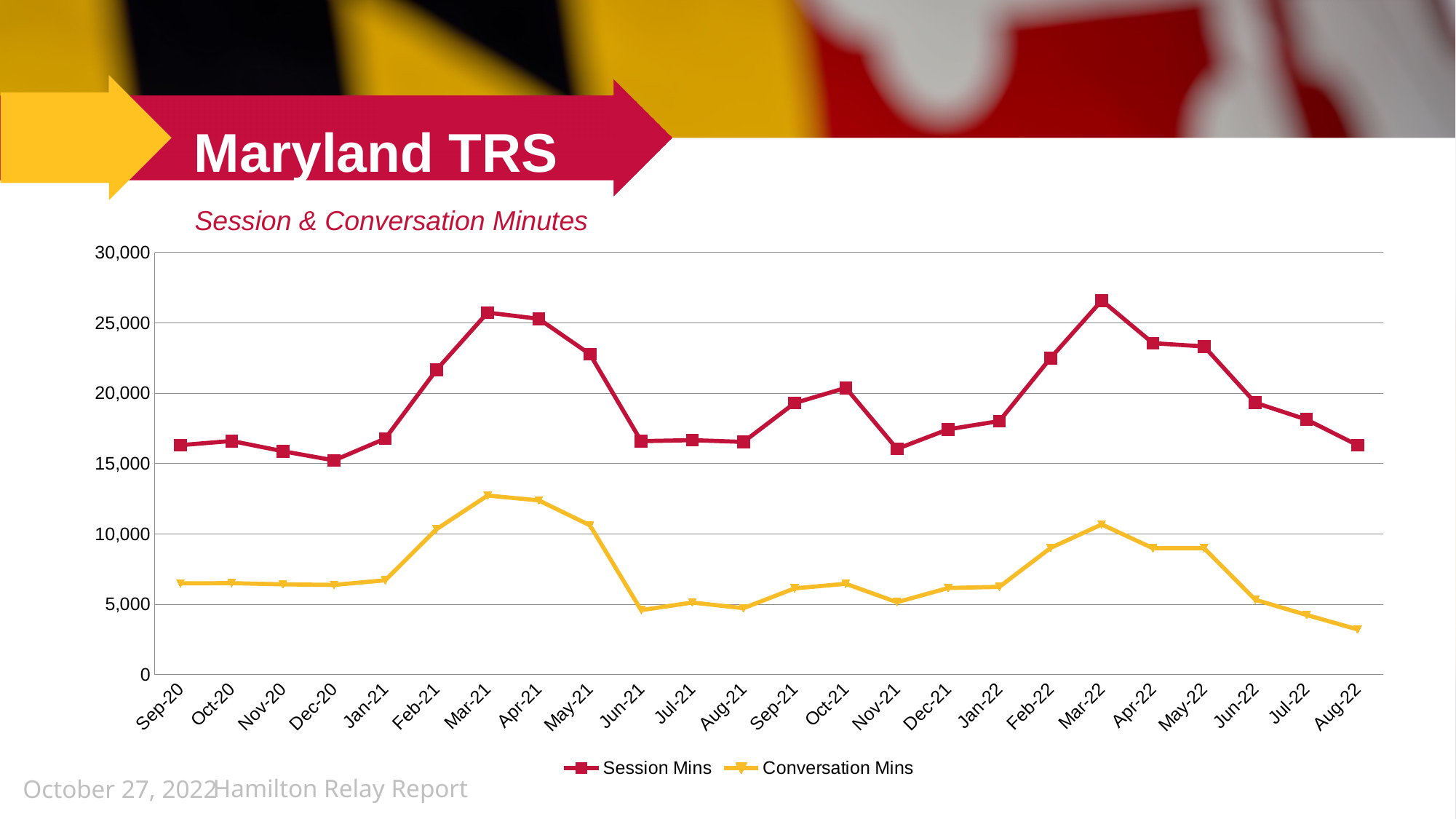
In which month are Conversation Mins at their lowest? Aug-22 Is the value for Conversation Mins in Mar-21 greater or less than 10,000? greater What kind of chart is shown on the slide? Line chart What is the subtitle of the chart? Session & Conversation Minutes In which month do Session Mins reach their highest value? Mar-22 In which month do Conversation Mins reach their highest value? Mar-21 Is the value for Session Mins in Mar-22 greater or less than 25,000? greater Do Session Mins rise or fall from Mar-22 to Aug-22? Fall How many series does the legend list? 2 Is the value for Conversation Mins in Aug-22 greater or less than 5,000? less How many months are plotted along the x axis? 24 Which is larger: Session Mins in Mar-21 or Session Mins in Oct-21? Mar-21